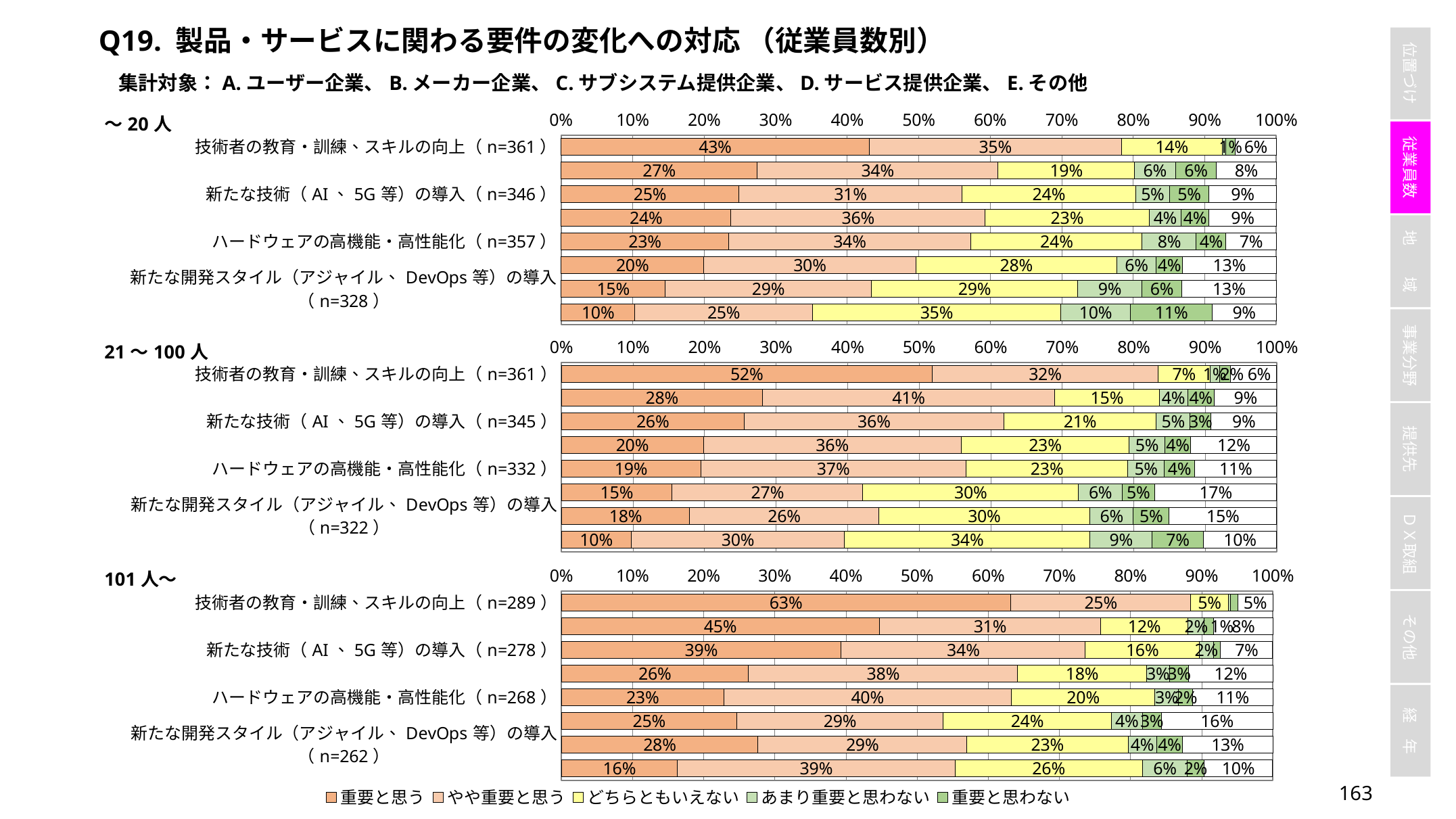
In the 101人～ chart, what percentage answered 重要と思う for 技術者の教育・訓練、スキルの向上 (n=289)? 63% What is the difference in percentage points between the 重要と思う share for 技術者の教育・訓練、スキルの向上 in the 101人～ chart (63%) and in the ～20人 chart (43%)? 20 percentage points In the 101人～ chart, what percentage answered やや重要と思う for 技術者の教育・訓練、スキルの向上 (n=289)? 25% How many series does the legend at the bottom of the slide list? 5 In the ～20人 chart, what percentage answered 重要と思う for 新たな技術（AI、5G等）の導入 (n=346)? 25% In the ～20人 chart, what percentage of respondents answered 重要と思う for 技術者の教育・訓練、スキルの向上 (n=361)? 43% Comparing the 重要と思う share for 技術者の教育・訓練、スキルの向上, which chart shows the larger value: ～20人 or 101人～? 101人～ In the 101人～ chart, what percentage answered 重要と思う for 新たな技術（AI、5G等）の導入 (n=278)? 39% In the ～20人 chart, is the 重要と思う value for 技術者の教育・訓練、スキルの向上 greater or less than 40%? greater In the 21～100人 chart, what percentage answered 重要と思う for 技術者の教育・訓練、スキルの向上 (n=361)? 52% What kind of chart is used on this slide? Stacked bar chart In the 21～100人 chart, what percentage answered 重要と思う for ハードウェアの高機能・高性能化 (n=332)? 19%